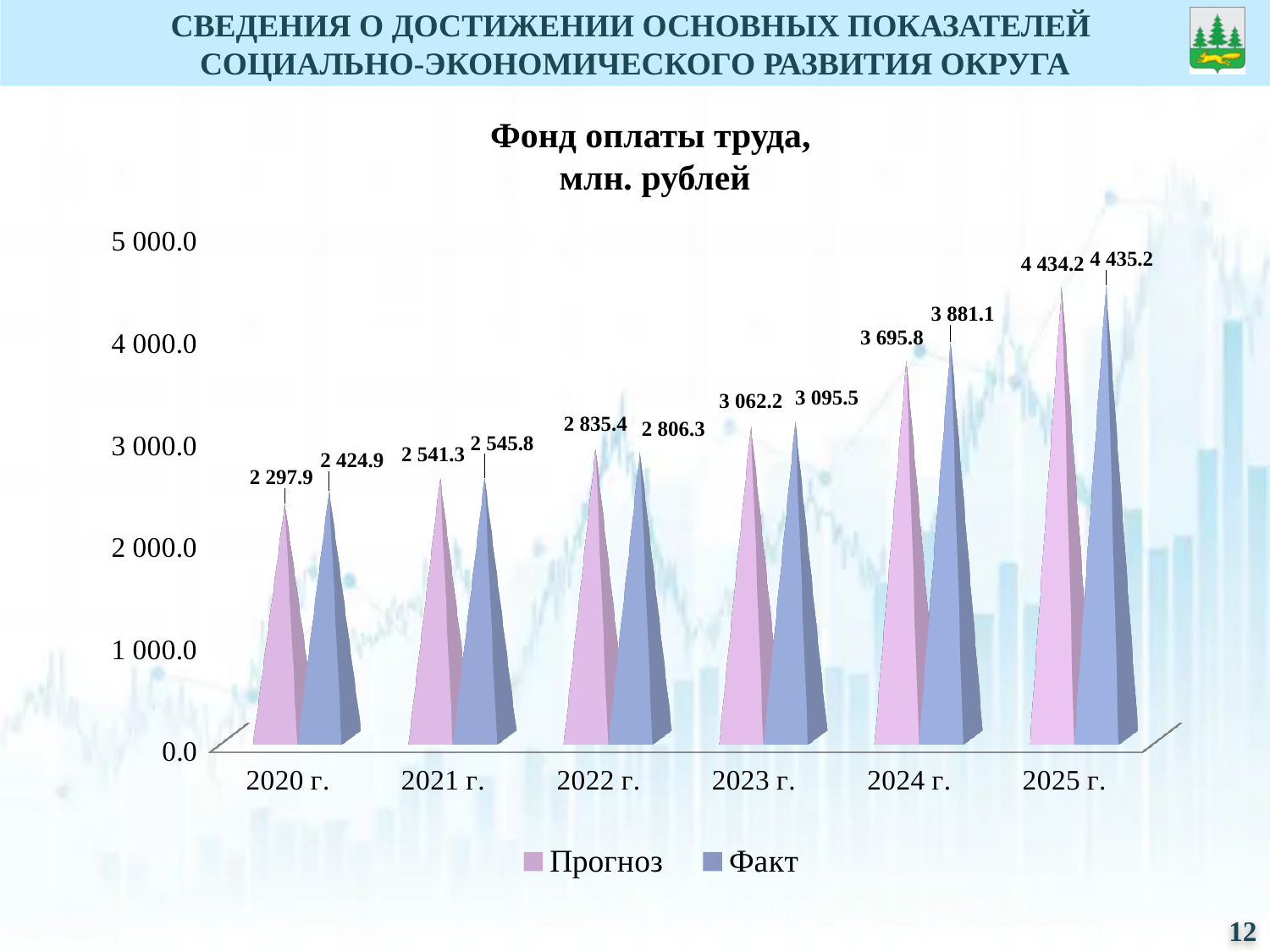
What is the Прогноз value for 2020 г.? 2 297.9 How many series does the legend list? 2 For 2022 г., which is larger: Прогноз or Факт? Прогноз Do the Факт values rise or fall from 2020 г. to 2025 г.? rise What is the Факт value for 2022 г.? 2 806.3 How many years are shown on the x axis? 6 What is the difference between the Факт and Прогноз values for 2024 г.? 185.3 Which year has the highest Факт value? 2025 г. What is the Факт value for 2024 г.? 3 881.1 What is the difference between the Факт and Прогноз values for 2020 г.? 127.0 What kind of chart is shown? bar chart Which year has the lowest Прогноз value? 2020 г.